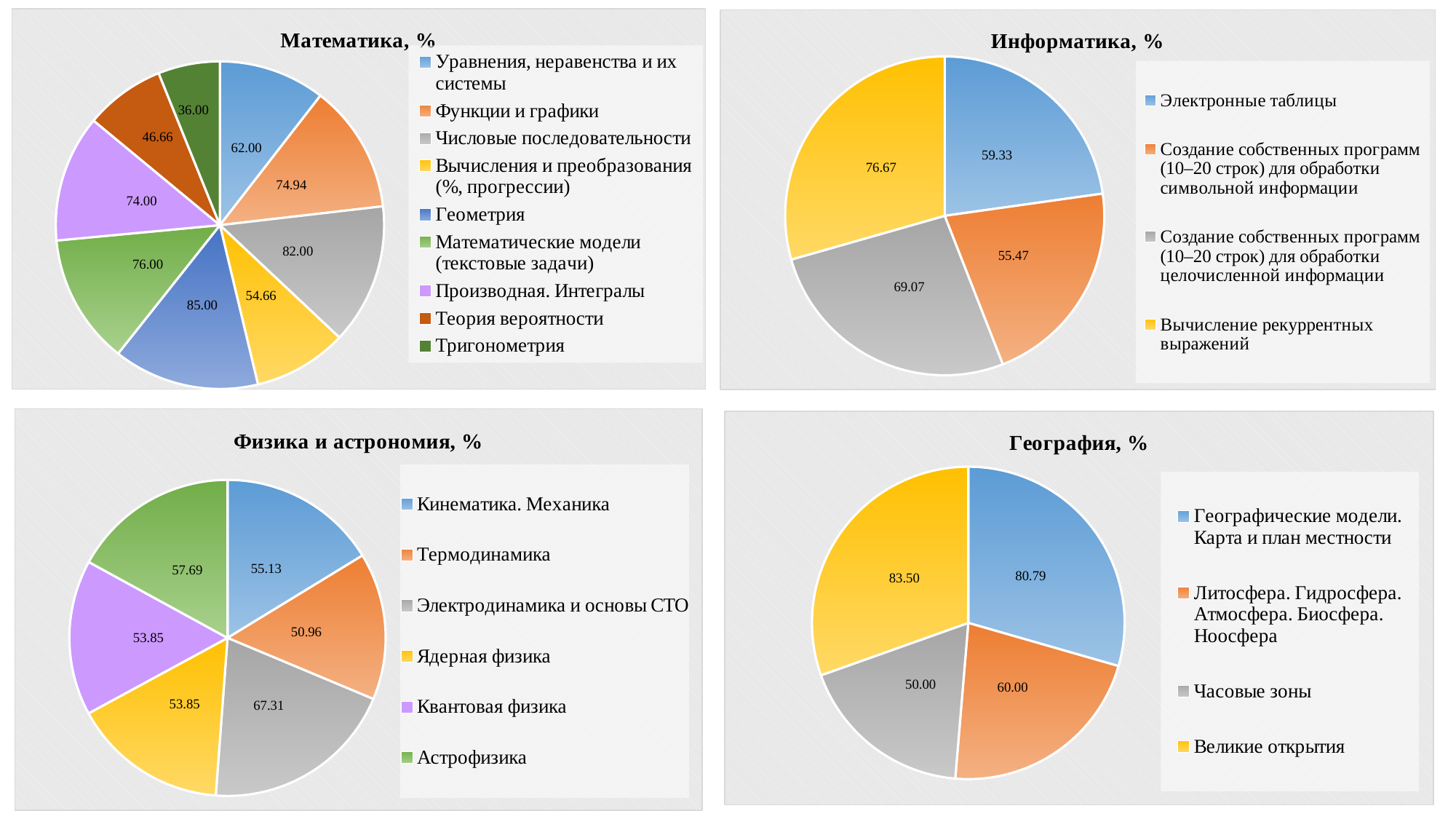
In the "Математика, %" chart, how many categories are shown? 9 In the "Информатика, %" chart, which category has the highest value? Вычисление рекуррентных выражений In the "География, %" chart, what is the difference between Великие открытия and Литосфера. Гидросфера. Атмосфера. Биосфера. Ноосфера? 23.50 In the "Информатика, %" chart, what is the value for Электронные таблицы? 59.33 In the "География, %" chart, what is the value for Часовые зоны? 50.00 In the "Математика, %" chart, what is the difference between Числовые последовательности and Теория вероятности? 35.34 In the "Математика, %" chart, what is the value for Геометрия? 85.00 In the "Физика и астрономия, %" chart, what is the value for Электродинамика и основы СТО? 67.31 In the "Математика, %" chart, which category has the lowest value? Тригонометрия In the "Физика и астрономия, %" chart, which is larger: Кинематика. Механика or Термодинамика? Кинематика. Механика How many charts are on the slide? 4 What kind of chart is "Физика и астрономия, %"? Pie chart